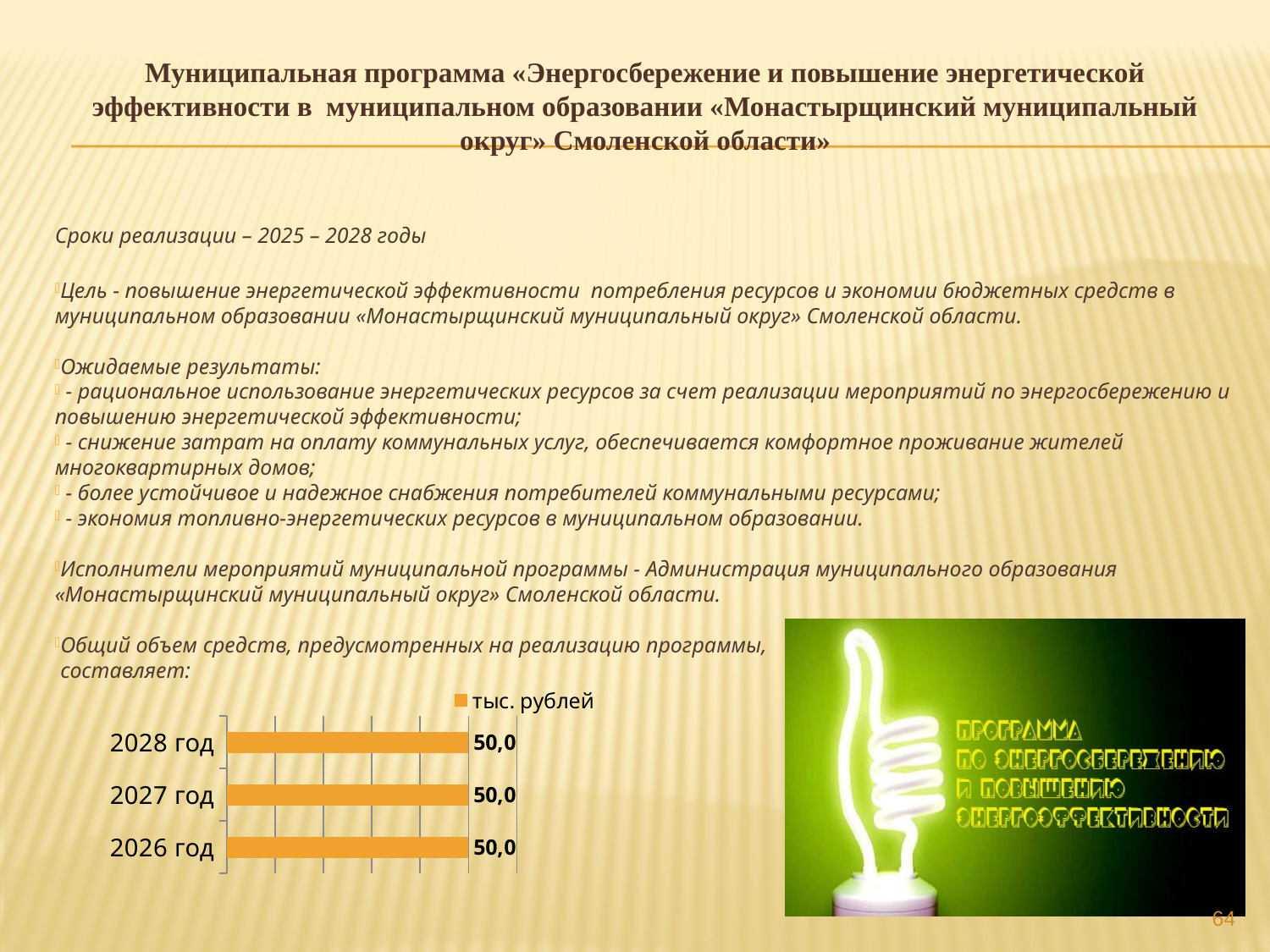
What is the value for 2027 год? 50,0 How many categories (years) are shown in the chart? 3 What is the name of the series shown in the legend? тыс. рублей What is the value for 2026 год? 50,0 What kind of chart is shown on the slide? bar chart Do the values change from 2026 год to 2028 год, or stay the same? stay the same What is the value for 2028 год? 50,0 What colour are the bars in the chart? orange How many series does the legend list? 1 What is the total of the values for 2026 год, 2027 год and 2028 год? 150,0 What is the difference between the values for 2028 год and 2026 год? 0,0